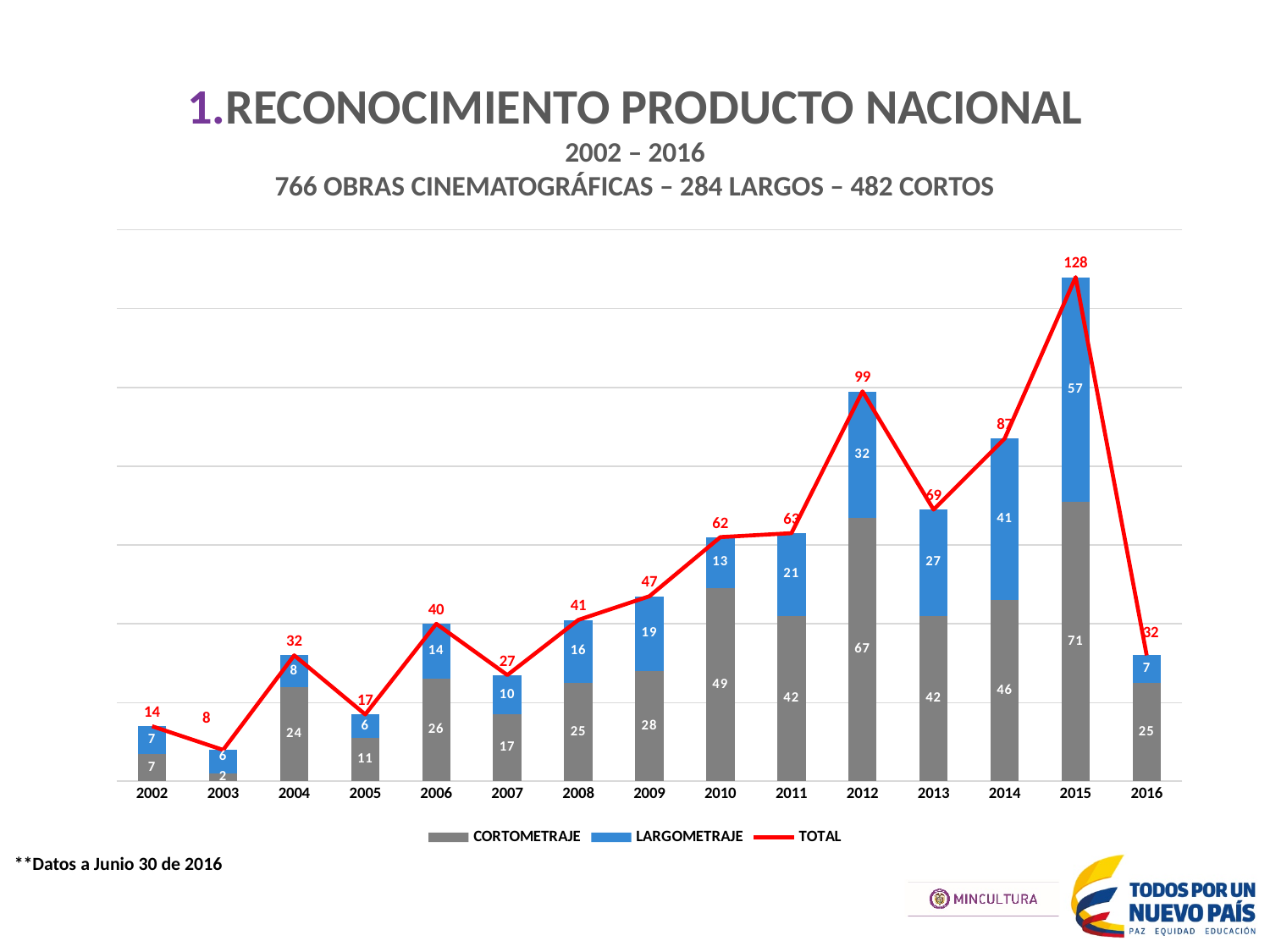
Which year has the highest TOTAL value? 2015 Which is larger, the LARGOMETRAJE value for 2011 or for 2013? 2013 Which series is drawn as a red line in the chart? TOTAL Which year has the lowest TOTAL value? 2003 What is the CORTOMETRAJE value for 2012? 67 What is the total of the stacked bar for 2010 (CORTOMETRAJE plus LARGOMETRAJE)? 62 What is the LARGOMETRAJE value for 2014? 41 What kind of chart is shown on the slide? Stacked bar chart with a line What is the difference between the TOTAL values for 2015 and 2012? 29 How many years are shown on the x axis? 15 What is the TOTAL value for 2009? 47 How many series does the legend list? 3